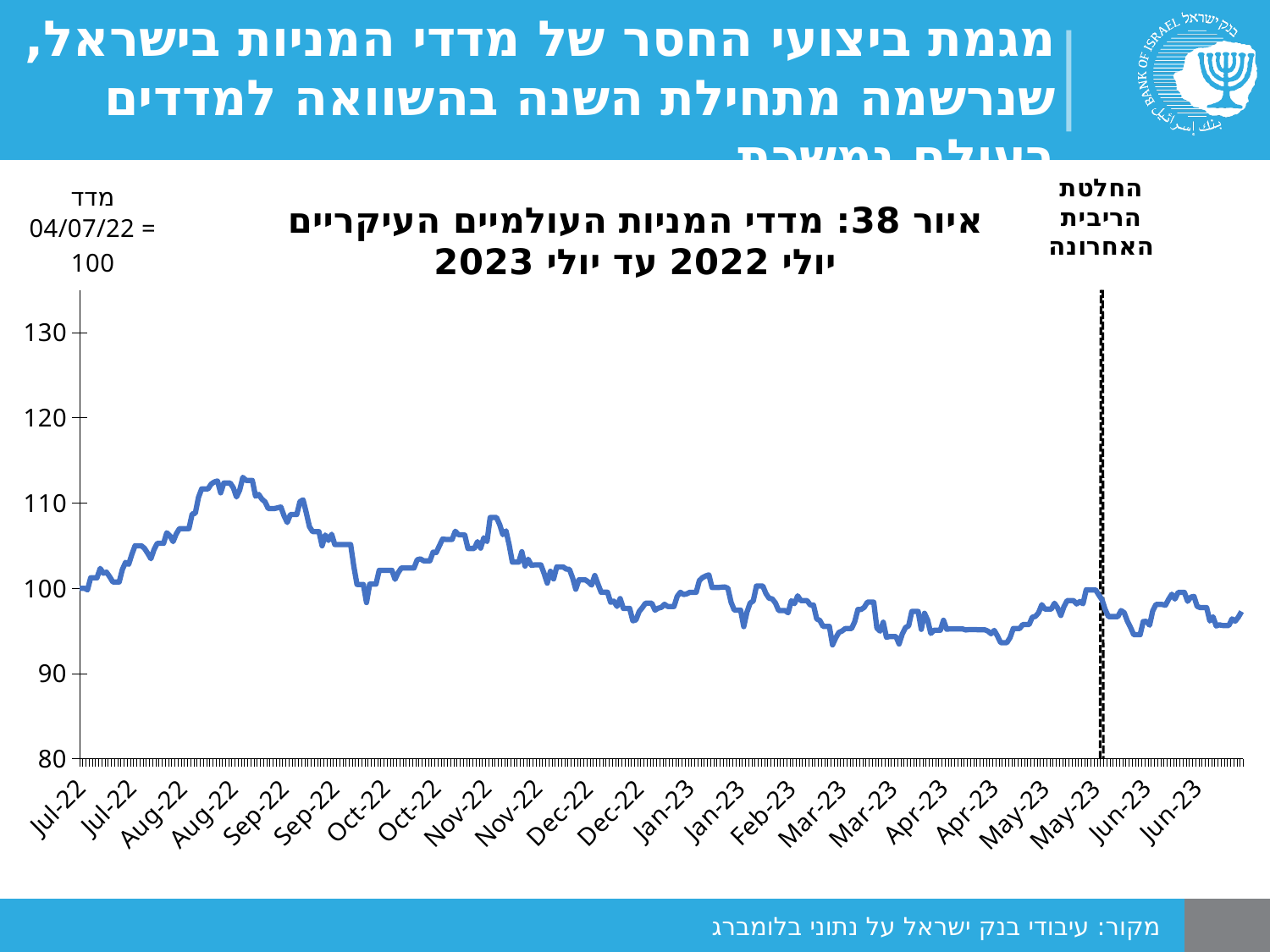
Is the peak value of the index in Aug-22 greater or less than 110? greater According to the note at the top left of the chart, what is the index value on 04/07/22? 100 Is the value of the index in Jan-23 greater or less than 90? greater What is the lowest value shown on the vertical axis? 80 Does the index rise or fall between its Aug-22 peak and Oct-22? fall Is the value of the index in Mar-23 greater or less than 100? less Does the index rise or fall between Jul-22 and Aug-22? rise Which is larger, the index value in Aug-22 or in Mar-23? Aug-22 How many data series are plotted in the chart? 1 What is the figure number given in the chart title? 38 What kind of chart is shown on the slide? line chart